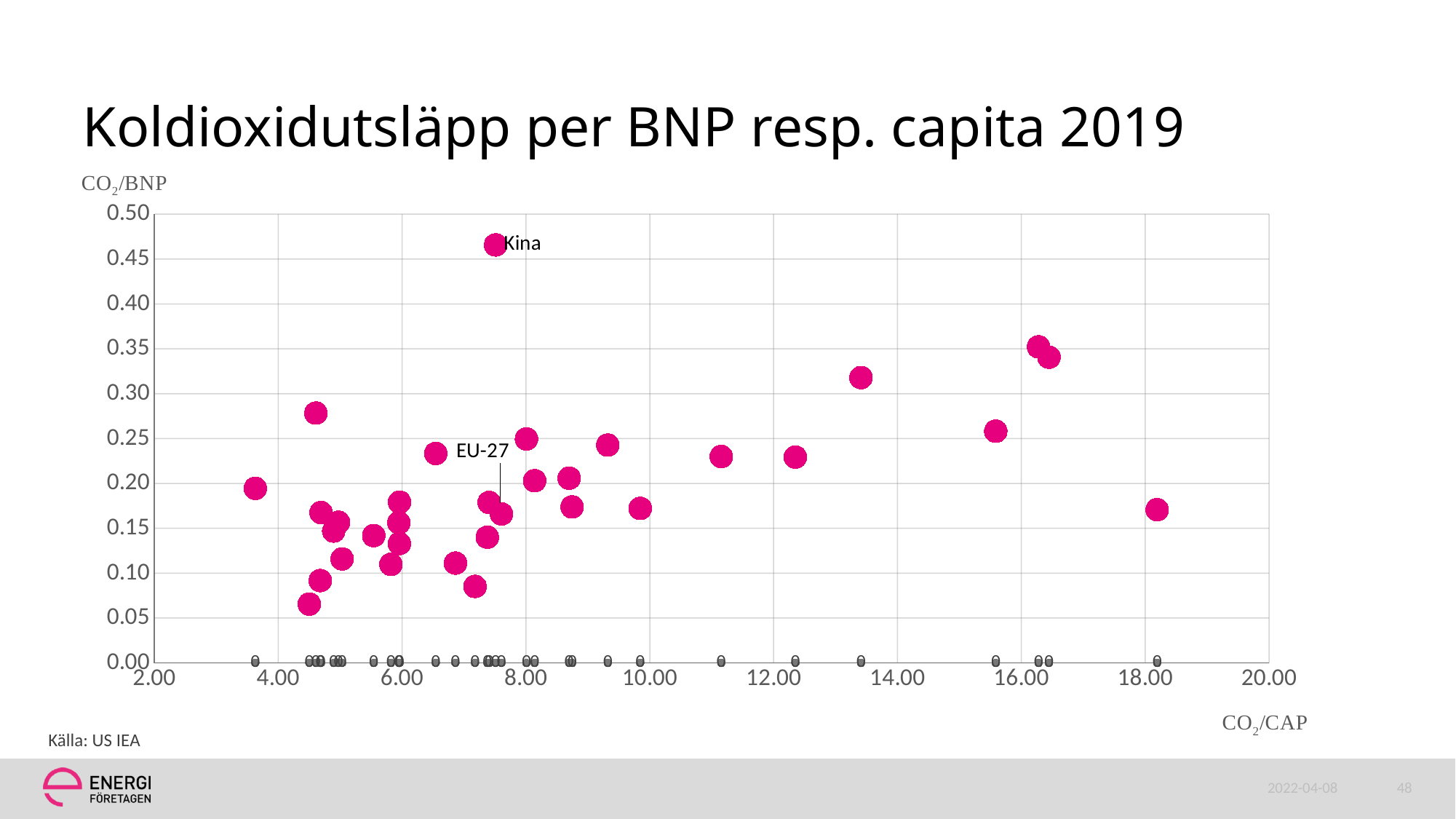
Which of the two labelled points, Kina or EU-27, has the higher CO2/BNP value? Kina Is the CO2/BNP value for EU-27 greater or less than 0.20? less Which labelled point has the highest CO2/BNP value in the chart? Kina Is the CO2/CAP value for Kina greater or less than 4.00? greater Is the CO2/BNP value for Kina greater or less than 0.40? greater What is the title of the chart? Koldioxidutsläpp per BNP resp. capita 2019 What is the label of the horizontal axis? CO2/CAP What kind of chart is shown on the slide? scatter chart